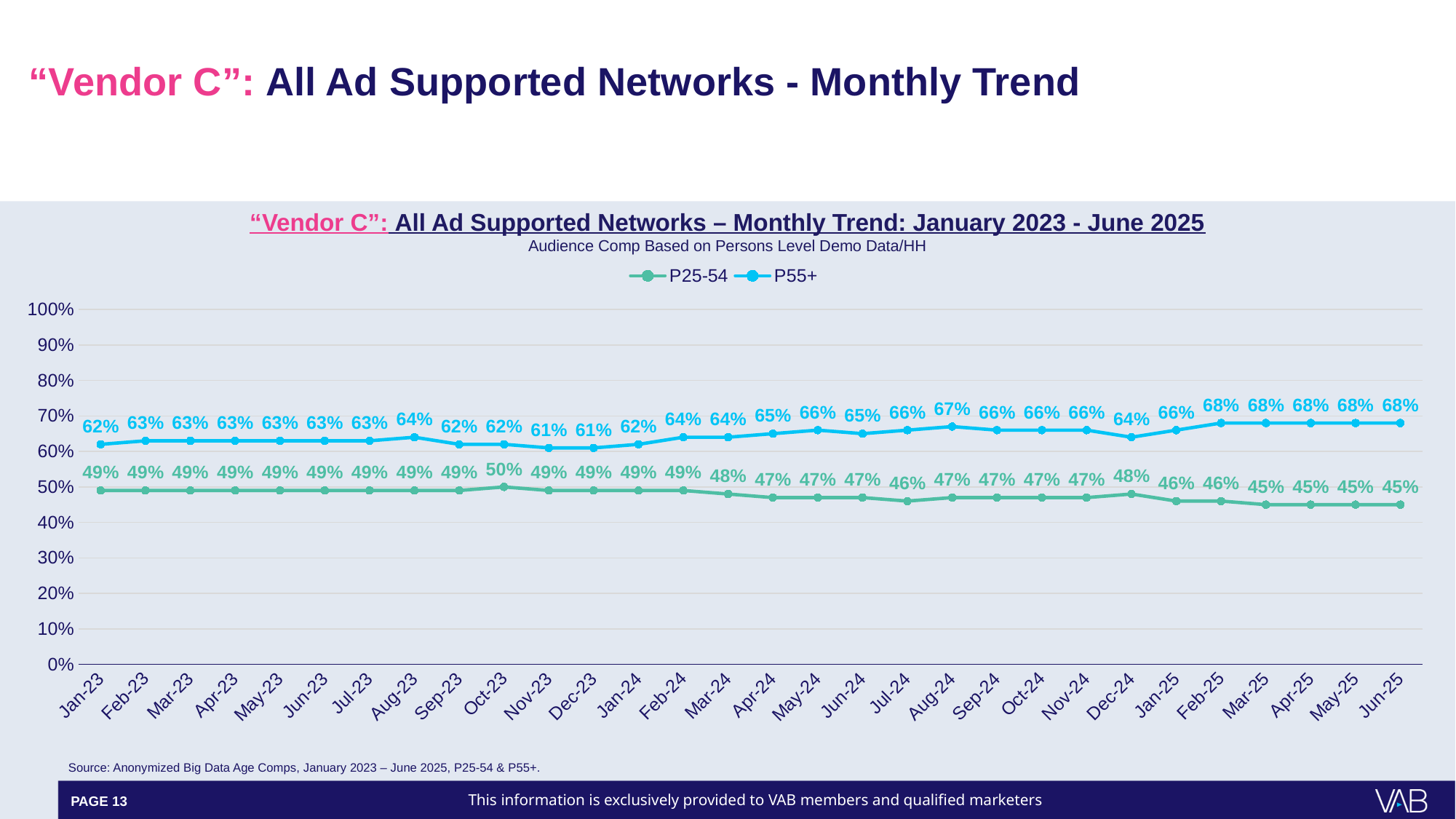
What is the lowest value shown for the P55+ series? 61% What is the P25-54 value for Oct-23? 50% What kind of chart is shown on the slide? Line chart What is the difference between the P55+ and P25-54 values in Jun-25? 23% In which month does the P25-54 series reach its highest value? Oct-23 What is the P55+ value for Jan-23? 62% What is the P25-54 value for Jun-25? 45% How many series does the legend list? 2 Does the P25-54 series generally rise or fall from Jan-23 to Jun-25? Fall Which series has the higher value in Dec-23, P25-54 or P55+? P55+ What is the P55+ value for Aug-24? 67% How many months are plotted on the x axis? 30